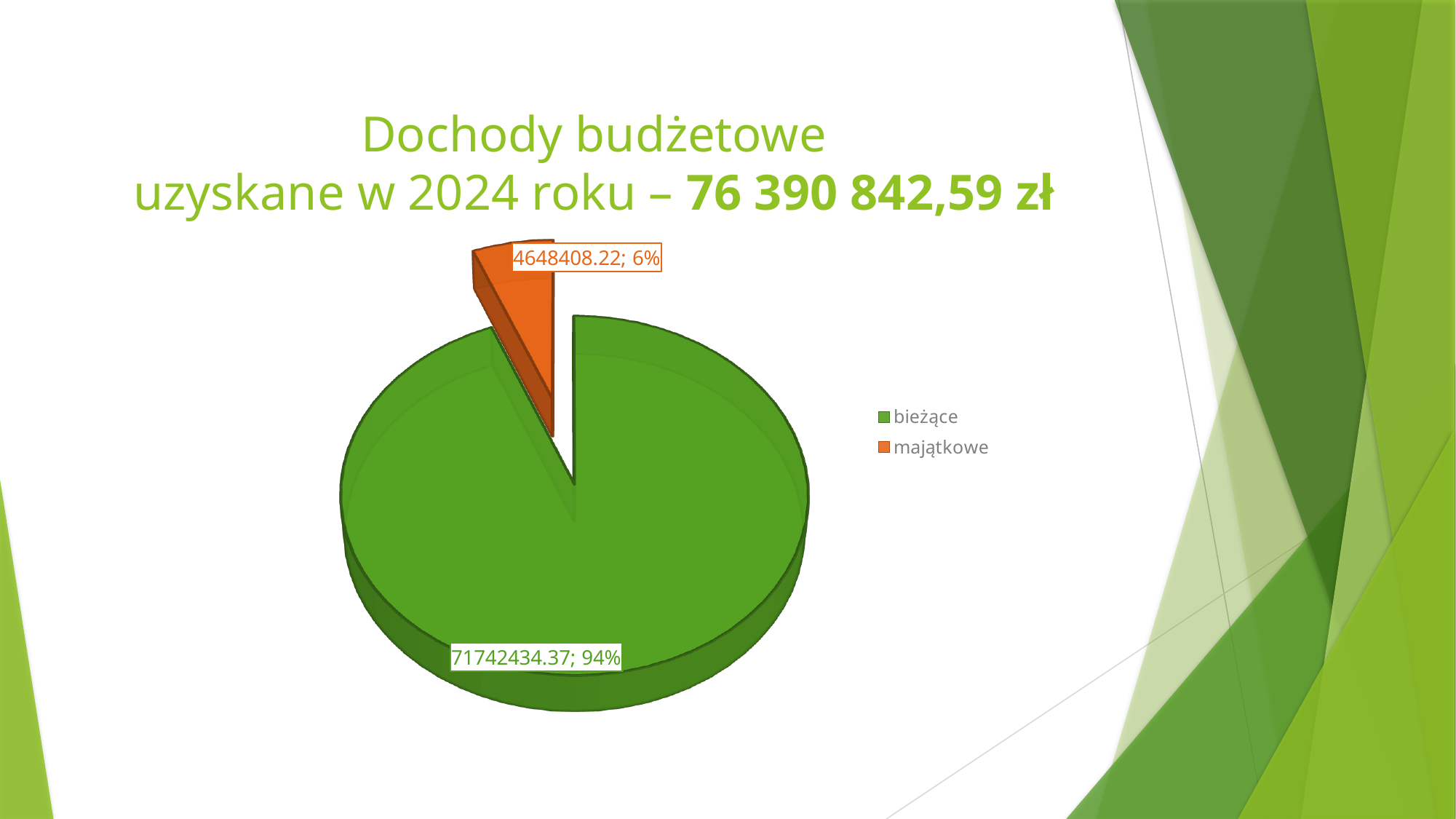
What kind of chart is shown on the slide? pie chart What colour is the majątkowe slice? orange How many slices does the pie chart have? 2 Which category has the smallest slice of the pie? majątkowe What is the value for majątkowe? 4648408.22 What share of the pie does the majątkowe slice represent? 6% How many entries does the legend list? 2 Which category has the largest slice of the pie? bieżące Which is larger, the value for bieżące or the value for majątkowe? bieżące What share of the pie does the bieżące slice represent? 94% What is the difference between the value for bieżące and the value for majątkowe? 67094026.15 What is the value for bieżące? 71742434.37